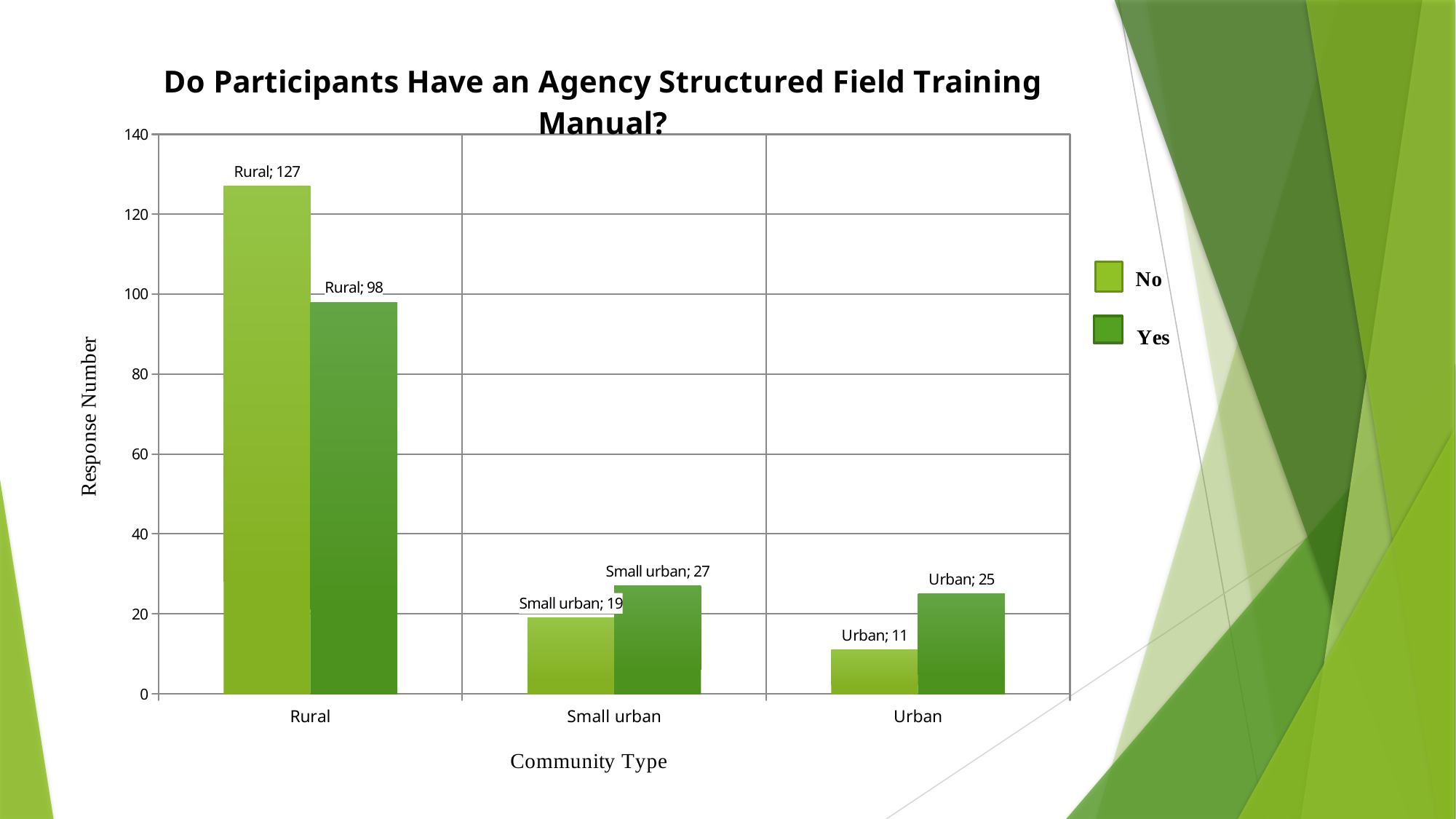
What is the 'No' value for Rural? 127 Which community type has the lowest 'No' value? Urban How many series does the legend list? 2 What is the 'Yes' value for Rural? 98 What is the 'No' value for Small urban? 19 What is the title of the y axis? Response Number What is the difference between the 'No' and 'Yes' values for Rural? 29 What kind of chart is shown on the slide? Bar chart How many community types are shown on the x axis? 3 What is the 'Yes' value for Urban? 25 For Small urban, which is larger, the 'No' value or the 'Yes' value? Yes Which community type has the highest 'No' value? Rural